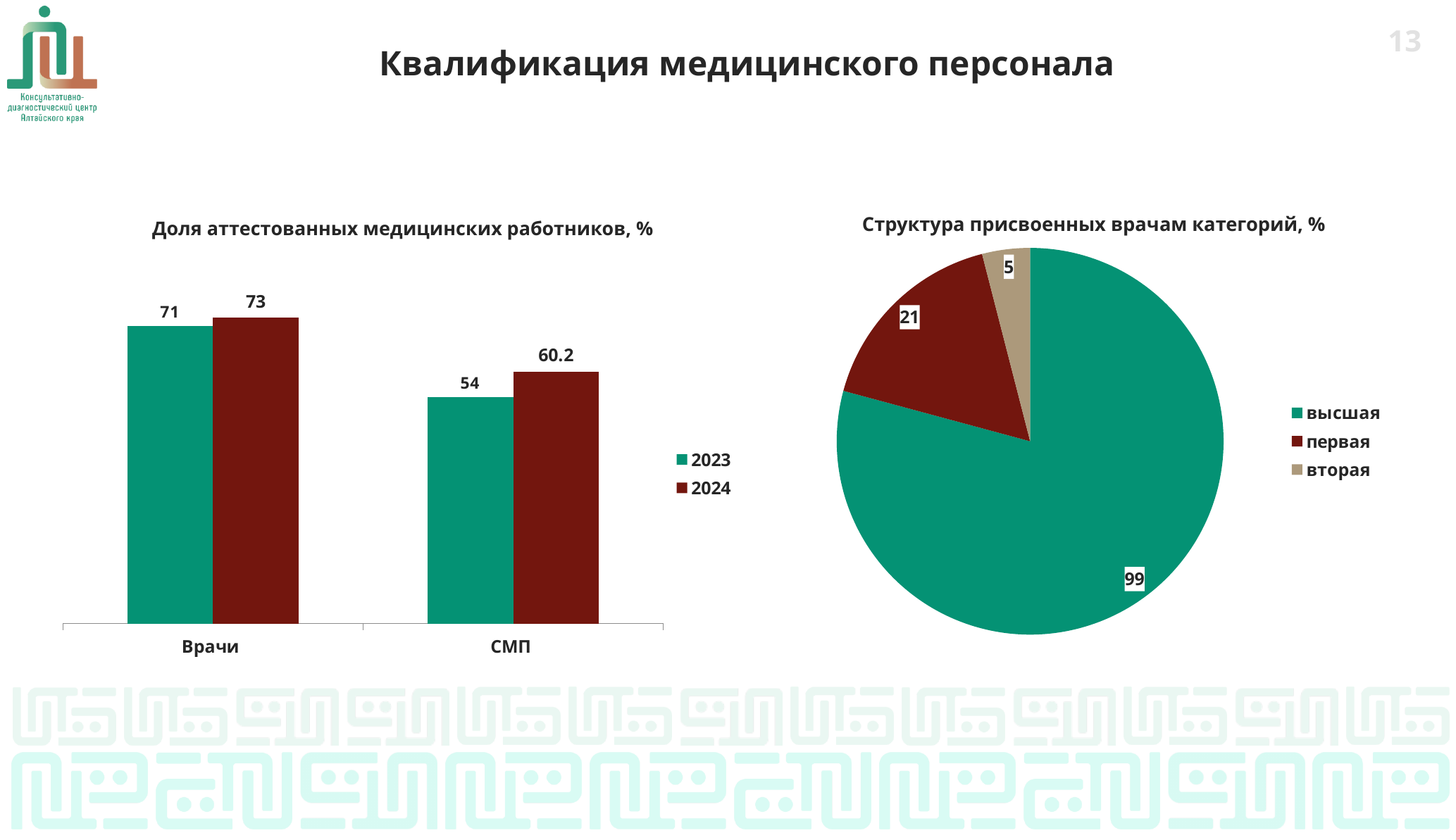
In the chart 'Доля аттестованных медицинских работников, %', by how much did the value for Врачи change from 2023 to 2024? 2 What kind of chart is 'Структура присвоенных врачам категорий, %'? Pie chart How many series does the legend of the chart 'Доля аттестованных медицинских работников, %' list? 2 In the chart 'Структура присвоенных врачам категорий, %', which category has the smallest slice? вторая What kind of chart is 'Доля аттестованных медицинских работников, %'? Bar chart In the chart 'Доля аттестованных медицинских работников, %', which is larger: Врачи in 2023 or СМП in 2024? Врачи in 2023 In the chart 'Структура присвоенных врачам категорий, %', what is the value labelled for первая? 21 In the chart 'Структура присвоенных врачам категорий, %', which category has the largest slice? высшая In the chart 'Доля аттестованных медицинских работников, %', what is the value for СМП in 2023? 54 In the chart 'Доля аттестованных медицинских работников, %', which category has the lowest value in 2023? СМП In the chart 'Доля аттестованных медицинских работников, %', what is the value for Врачи in 2024? 73 In the chart 'Доля аттестованных медицинских работников, %', what is the value for СМП in 2024? 60.2